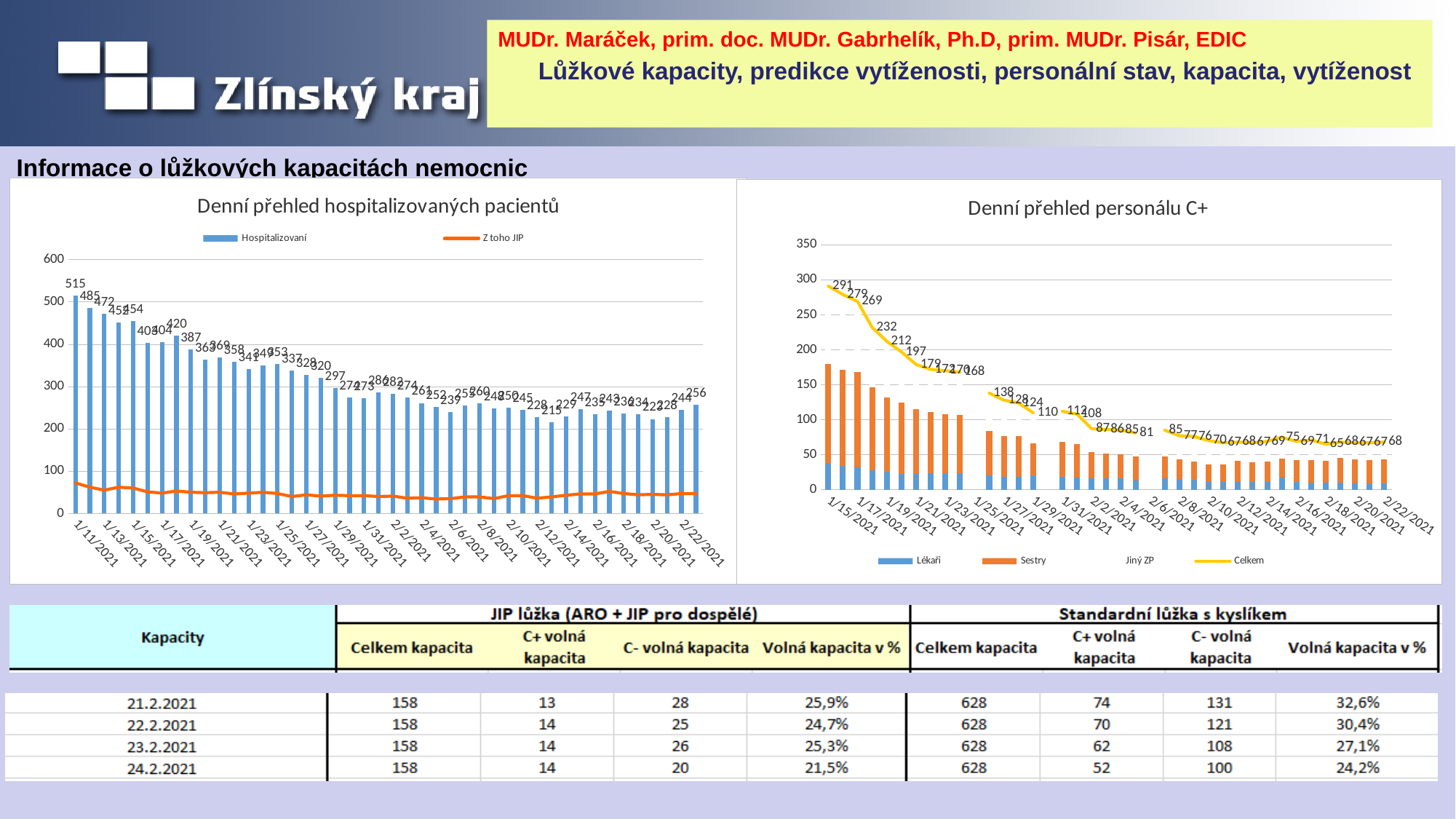
In the chart 'Denní přehled hospitalizovaných pacientů', what is the Hospitalizovaní value for 2/22/2021? 244 In the chart 'Denní přehled personálu C+', which is larger: the Celkem value on 1/15/2021 or on 2/22/2021? 1/15/2021 How many series does the legend of the chart 'Denní přehled hospitalizovaných pacientů' list? 2 In the chart 'Denní přehled hospitalizovaných pacientů', on which date is the Hospitalizovaní value highest? 1/11/2021 In the chart 'Denní přehled hospitalizovaných pacientů', what is the difference between the Hospitalizovaní values on 1/11/2021 and 2/22/2021? 271 In the chart 'Denní přehled hospitalizovaných pacientů', what is the lowest Hospitalizovaní value shown? 215 In the chart 'Denní přehled personálu C+', what is the Celkem value for 1/15/2021? 291 In the chart 'Denní přehled hospitalizovaných pacientů', what is the Hospitalizovaní value for 1/11/2021? 515 How many series does the legend of the chart 'Denní přehled personálu C+' list? 4 In the chart 'Denní přehled hospitalizovaných pacientů', do the Hospitalizovaní values generally rise or fall from left to right? fall In the chart 'Denní přehled personálu C+', is the Celkem value for 1/15/2021 greater or less than 250? greater In the chart 'Denní přehled hospitalizovaných pacientů', what kind of chart is used for the Hospitalizovaní series? bar chart